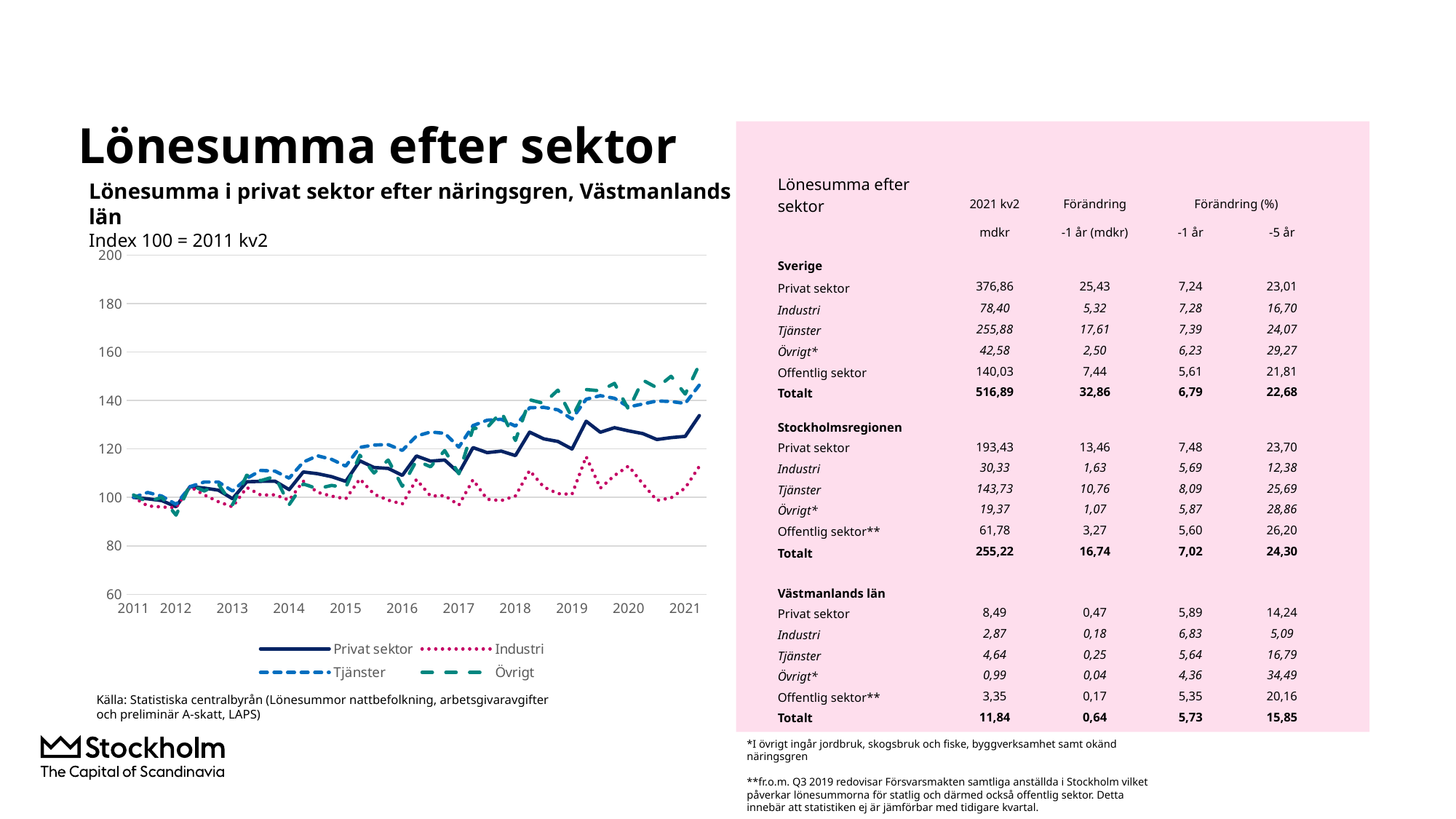
Is the value for Privat sektor at the end of 2021 greater or less than 120? greater Which series are listed in the chart legend? Privat sektor, Industri, Tjänster, Övrigt Is the value for Industri at the end of 2021 greater or less than 120? less Does the Privat sektor series rise or fall overall from 2011 to 2021? Rise How many series does the chart legend list? 4 At the end of 2021, which is larger: the value for Tjänster or the value for Industri? Tjänster Is the value for Övrigt at the end of 2021 greater or less than 140? greater What is the title of the chart? Lönesumma i privat sektor efter näringsgren, Västmanlands län Which series has the lowest value at the end of the chart in 2021? Industri Which series has the highest value at the end of the chart in 2021? Övrigt What kind of chart is shown on the slide? Line chart How many years are labelled on the x axis of the chart? 11